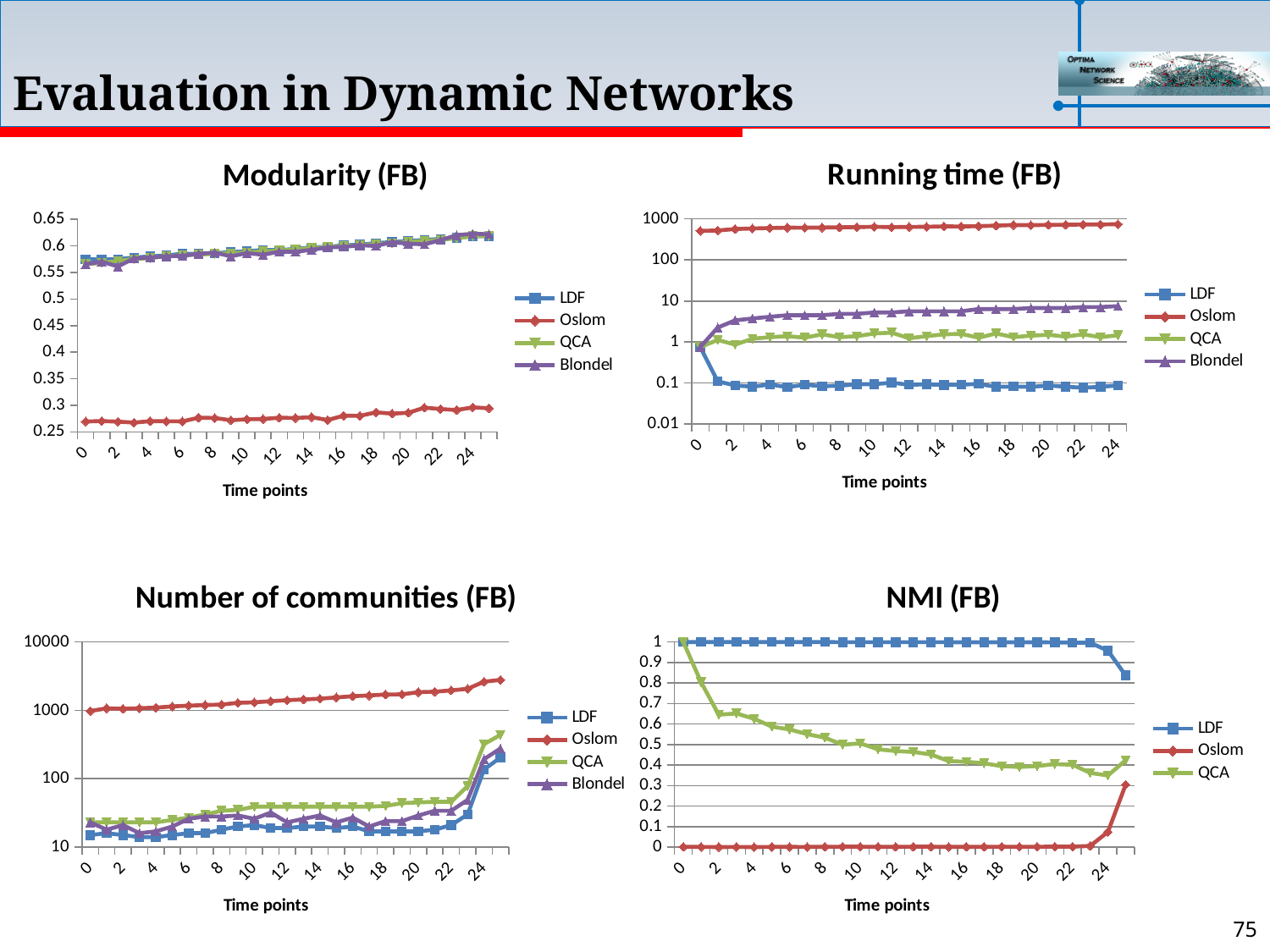
In the Modularity (FB) chart, which series has the lowest modularity across the time points? Oslom In the Number of communities (FB) chart, which series has the highest number of communities? Oslom In the Number of communities (FB) chart, is the value for Oslom at time point 24 greater or less than 1000? greater In the Modularity (FB) chart, is the value for Oslom at time point 0 greater or less than 0.3? less In the Running time (FB) chart, which series has the lowest running time at time point 10? LDF In the NMI (FB) chart, do the values for QCA generally rise or fall from time point 0 to time point 20? fall How many series does the legend of the Running time (FB) chart list? 4 What kind of chart is the Modularity (FB) chart? line chart In the Running time (FB) chart, which series has the highest running time? Oslom In the Running time (FB) chart, is the value for Blondel at time point 20 greater or less than 1? greater How many series does the legend of the NMI (FB) chart list? 3